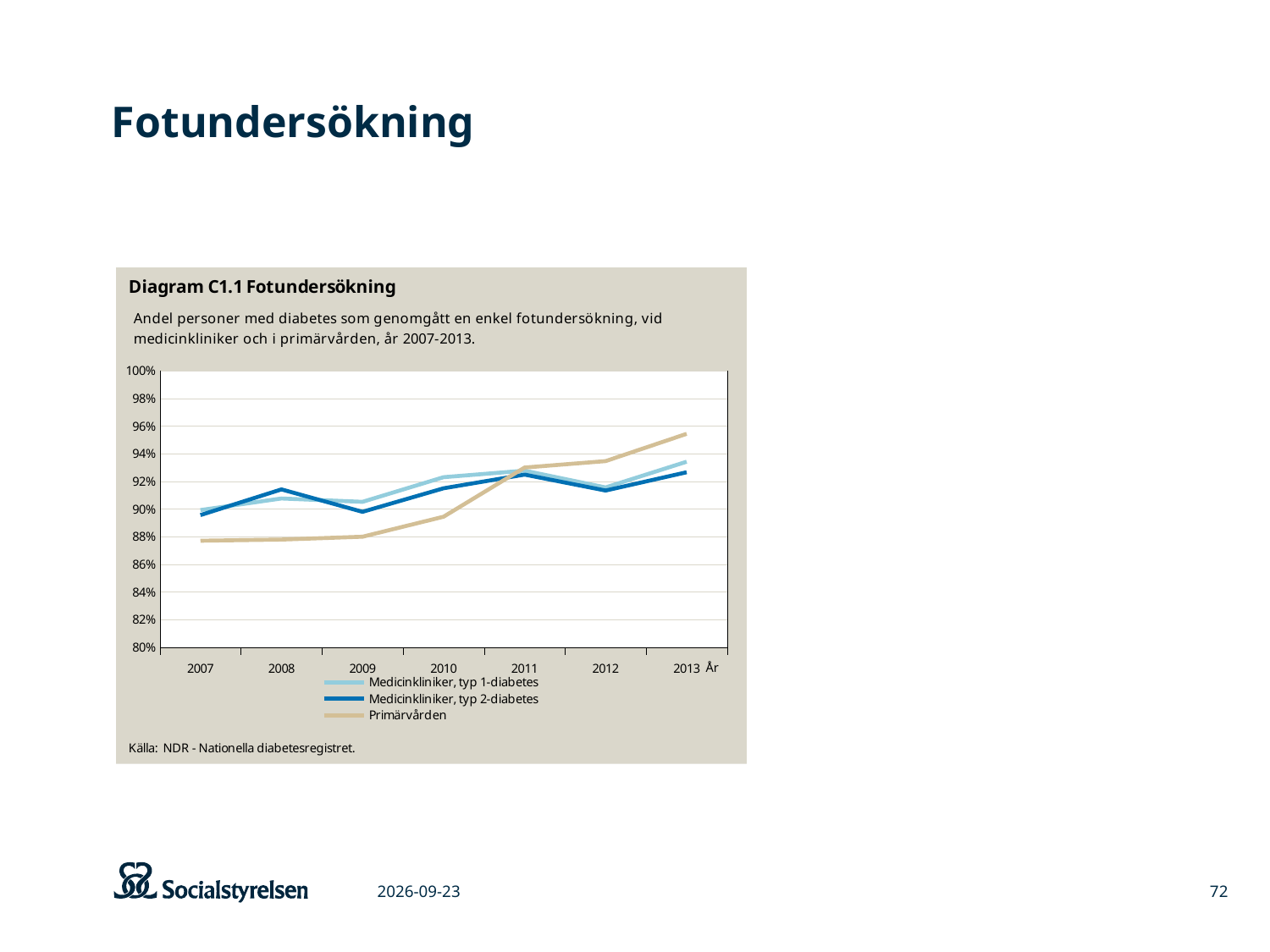
Which series has the highest value in 2013? Primärvården Does the Primärvården series rise or fall from 2007 to 2013? rise How many years are plotted along the x axis? 7 Is the value for Medicinkliniker, typ 1-diabetes in 2013 greater or less than 92%? greater Which series has the lowest value in 2007? Primärvården What source is cited below the chart? NDR - Nationella diabetesregistret. What kind of chart is shown in Diagram C1.1 Fotundersökning? line chart How many series does the legend list? 3 Is the value for Medicinkliniker, typ 2-diabetes in 2012 greater or less than 92%? less Is the value for Primärvården in 2010 greater or less than 90%? less In 2010, which is higher: Medicinkliniker, typ 1-diabetes or Primärvården? Medicinkliniker, typ 1-diabetes